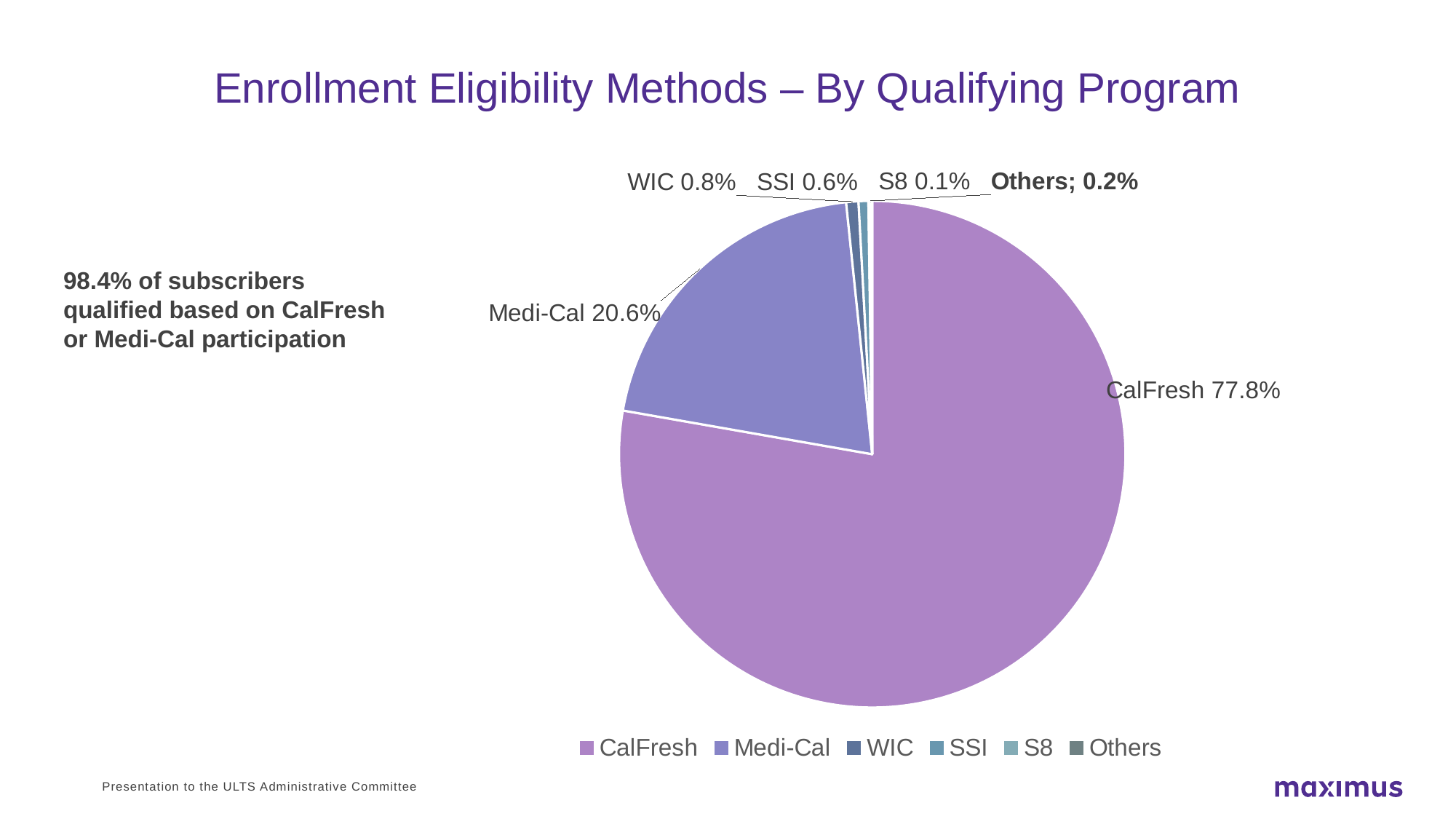
Which qualifying program has the largest slice? CalFresh What is the title of the chart? Enrollment Eligibility Methods – By Qualifying Program What is the value shown for SSI? 0.6% What is the value shown for S8? 0.1% What share of the pie does CalFresh represent? 77.8% What is the value shown for WIC? 0.8% Which is larger, the WIC share or the SSI share? WIC What is the difference between the CalFresh and Medi-Cal shares? 57.2% How many categories does the legend list? 6 What type of chart is shown on the slide? pie chart What is the value shown for Medi-Cal? 20.6% Which qualifying program has the smallest slice? S8